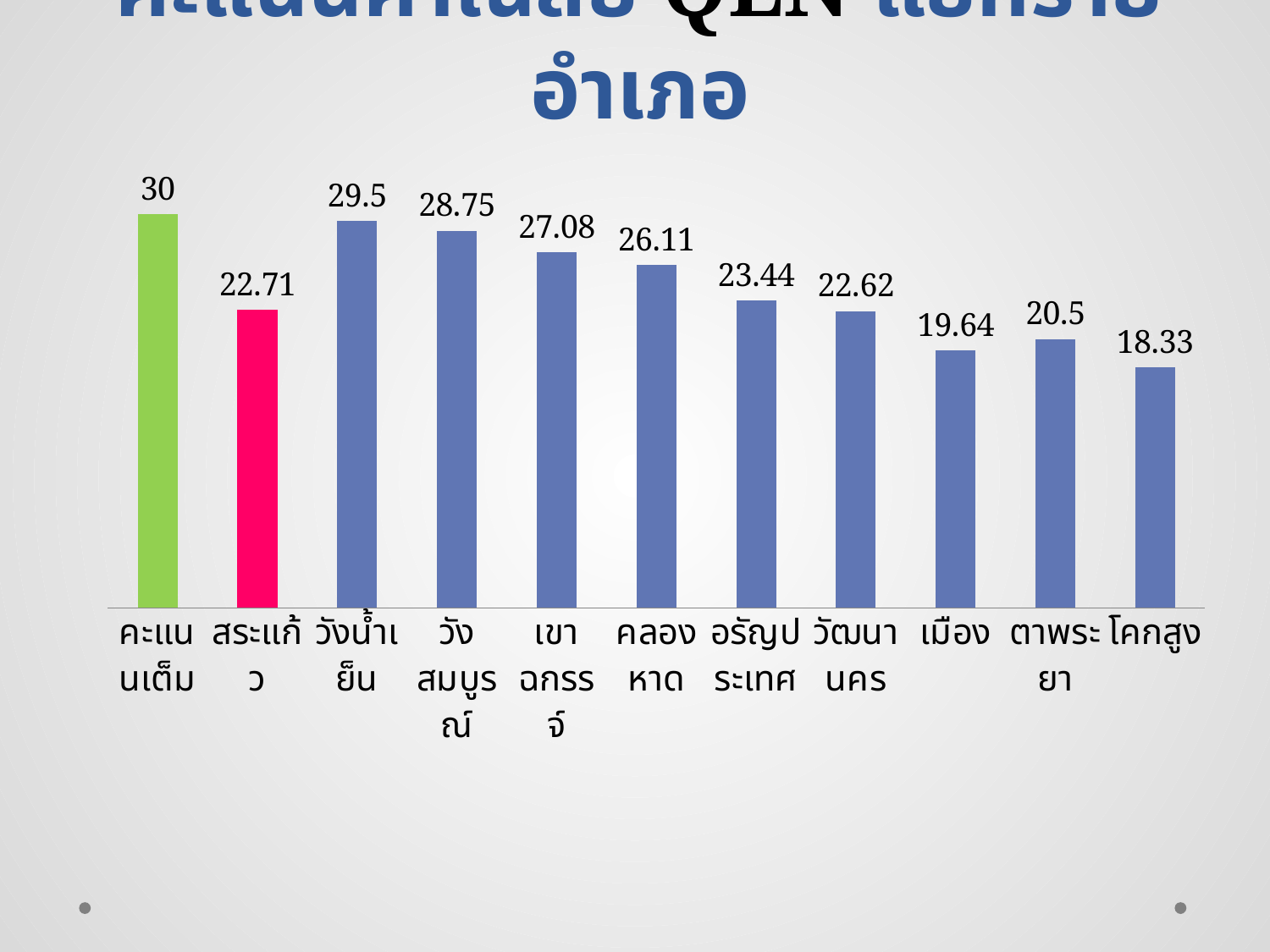
Excluding คะแนนเต็ม, which district has the highest value? วังน้ำเย็น What is the difference between the values for คะแนนเต็ม and สระแก้ว? 7.29 What is the value for วังน้ำเย็น? 29.5 How many bars are shown in the chart? 11 Which is larger, the value for เมือง or the value for ตาพระยา? ตาพระยา Which category has the lowest value? โคกสูง What kind of chart is shown on the slide? Bar chart Which category has the highest value? คะแนนเต็ม What is the difference between the values for วังสมบูรณ์ and เขาฉกรรจ์? 1.67 What is the value for โคกสูง? 18.33 What is the value for อรัญประเทศ? 23.44 What is the value for สระแก้ว? 22.71